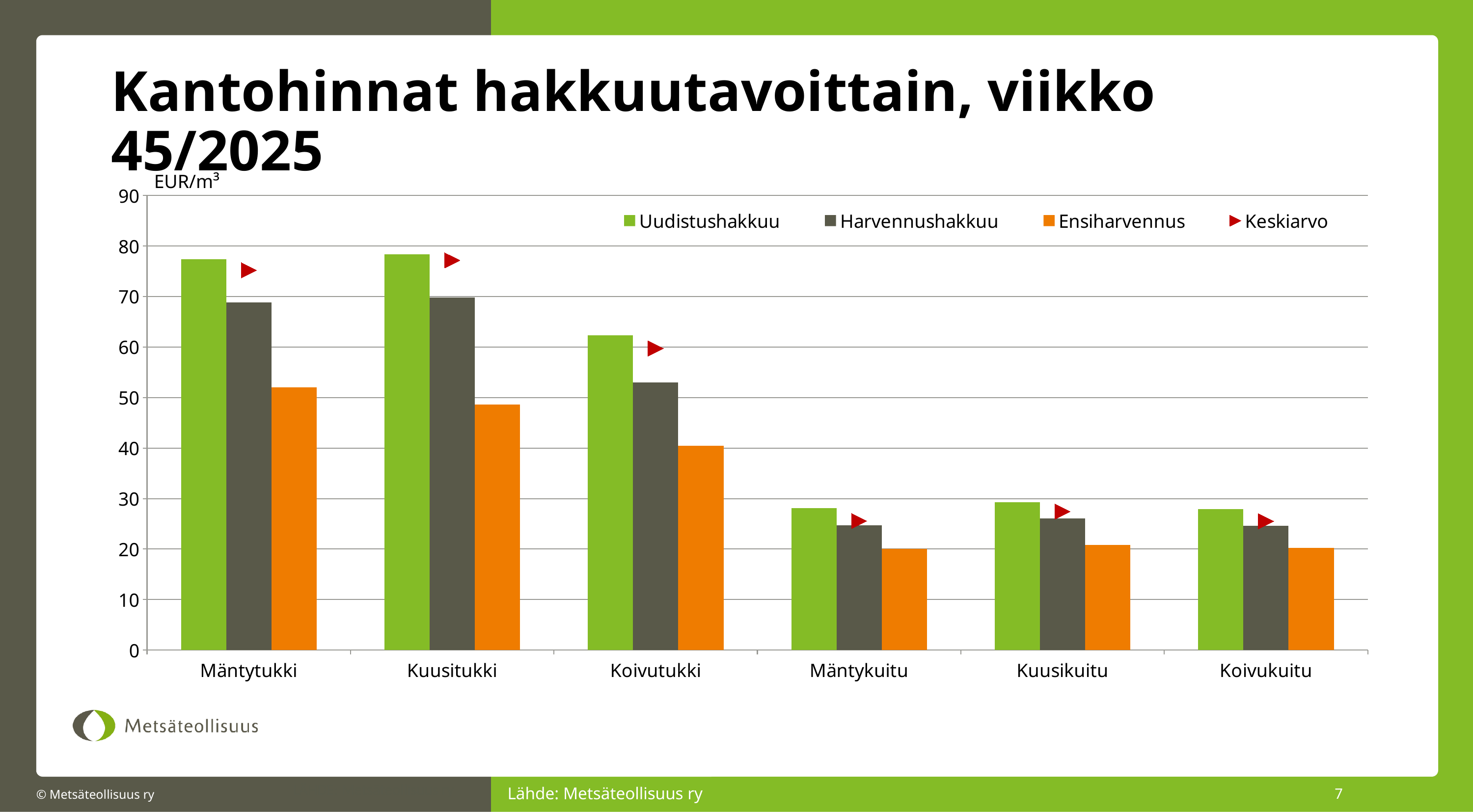
How many series does the legend list? 4 How many categories are shown on the x axis? 6 Is the Harvennushakkuu value for Koivutukki greater or less than 50? greater Is the Ensiharvennus value for Kuusitukki greater or less than 50? less What unit is shown above the y axis? EUR/m³ Which is larger: the Uudistushakkuu value for Koivutukki or the Harvennushakkuu value for Kuusitukki? Harvennushakkuu for Kuusitukki Which is larger: the Ensiharvennus value for Mäntytukki or for Kuusitukki? Mäntytukki Which category has the lowest Harvennushakkuu value among the tukki categories (Mäntytukki, Kuusitukki, Koivutukki)? Koivutukki What kind of chart is shown on the slide? bar chart Is the Uudistushakkuu value for Mäntykuitu greater or less than 30? less Which category has the highest Ensiharvennus value? Mäntytukki